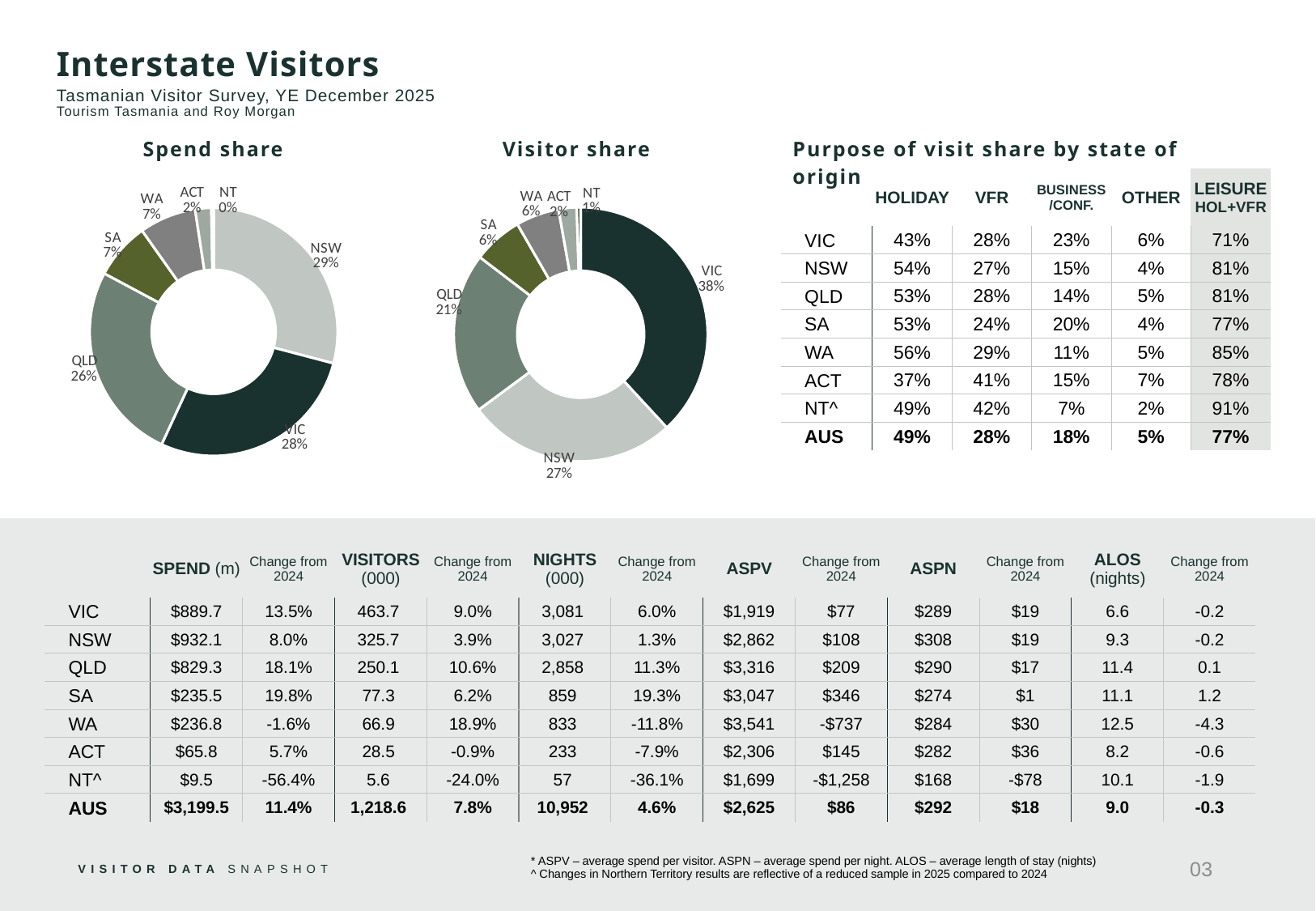
In the Visitor share chart, which state has the largest share? VIC How many states or territories are shown in the Spend share chart? 7 In the Spend share chart, what share does NSW have? 29% In the Visitor share chart, what share does VIC have? 38% In the Visitor share chart, what share does QLD have? 21% In the Spend share chart, what is the combined share of SA and WA? 14% In the Spend share chart, which state has the largest share? NSW In the Spend share chart, which state or territory has the smallest share? NT In the Visitor share chart, what is the difference between the VIC share and the NSW share? 11% In the Visitor share chart, which state or territory has the smallest share? NT In the Spend share chart, which is larger, the QLD share or the SA share? QLD What type of chart is the Visitor share chart? Donut chart